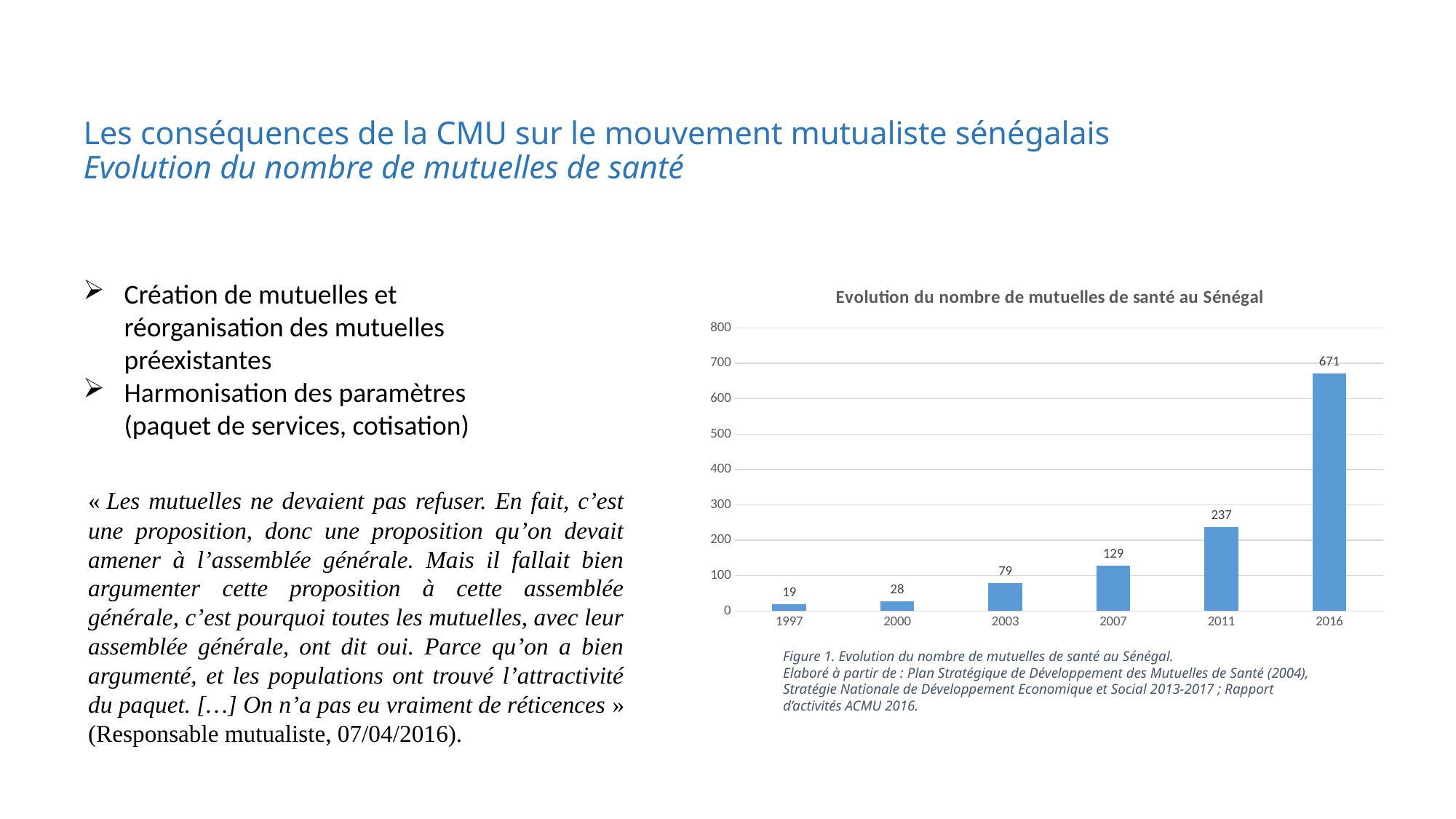
What is the value for 2016? 671 Which year has the highest value? 2016 Do the values rise or fall from 1997 to 2016? rise Is the value for 2011 greater or less than 200? greater Which is larger, the value for 2011 or the value for 2007? 2011 What is the difference between the values for 2016 and 2011? 434 What is the value for 2007? 129 How many years are shown on the x axis? 6 What is the difference between the values for 2003 and 2000? 51 What is the value for 1997? 19 What kind of chart is shown? bar chart Which year has the lowest value? 1997